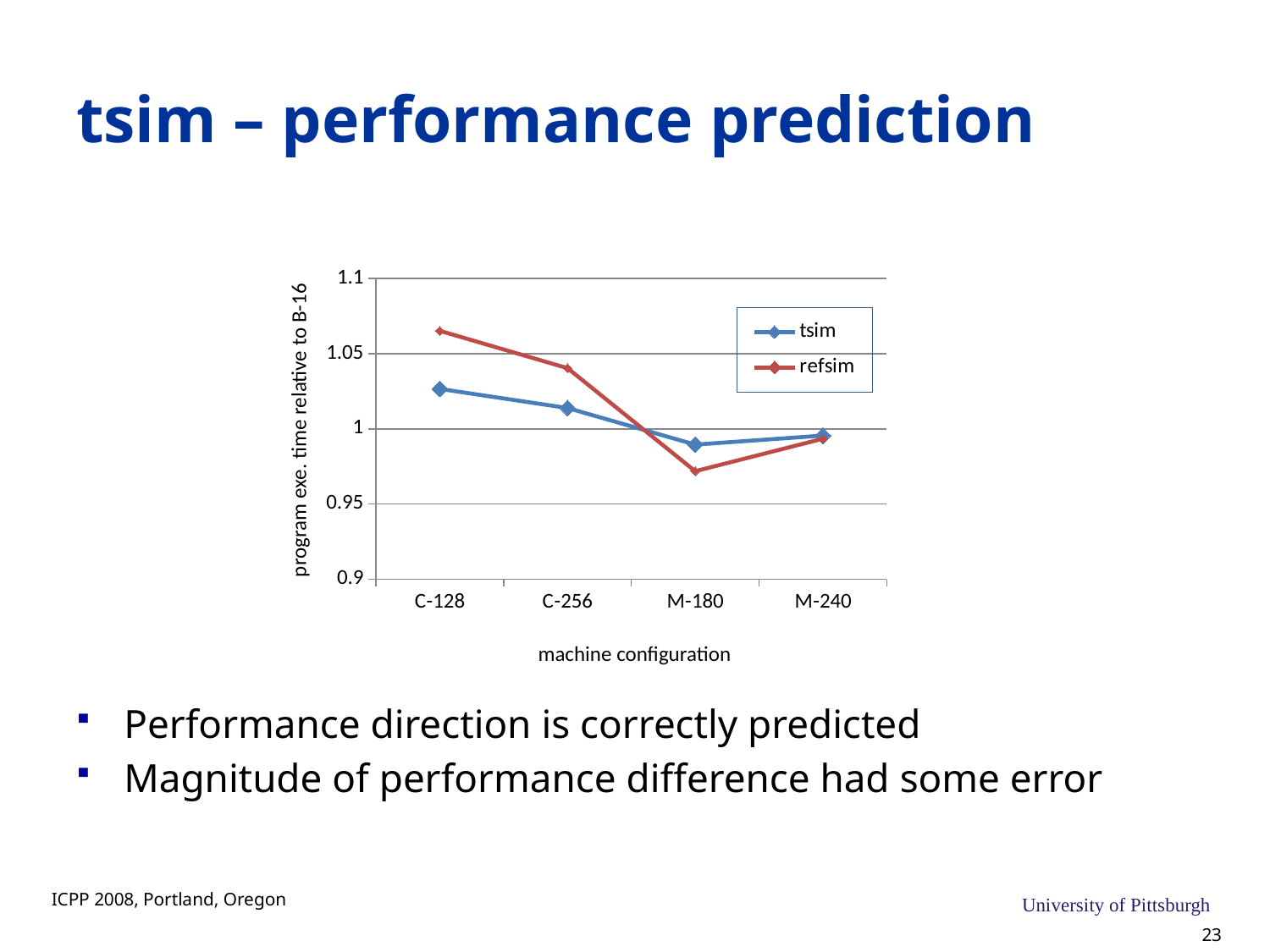
Which series has the higher value at M-180, tsim or refsim? tsim At which machine configuration is the refsim value highest? C-128 What is the label of the y axis? program exe. time relative to B-16 Which series has the higher value at C-128, tsim or refsim? refsim How many series does the legend list? 2 Is the refsim value for C-128 greater or less than 1.05? greater What kind of chart is shown on the slide? line chart How many machine configurations are shown on the x axis? 4 Is the tsim value for C-128 greater or less than 1.05? less Is the refsim value for M-180 greater or less than 1? less Which series has the higher value at C-256, tsim or refsim? refsim At which machine configuration is the refsim value lowest? M-180